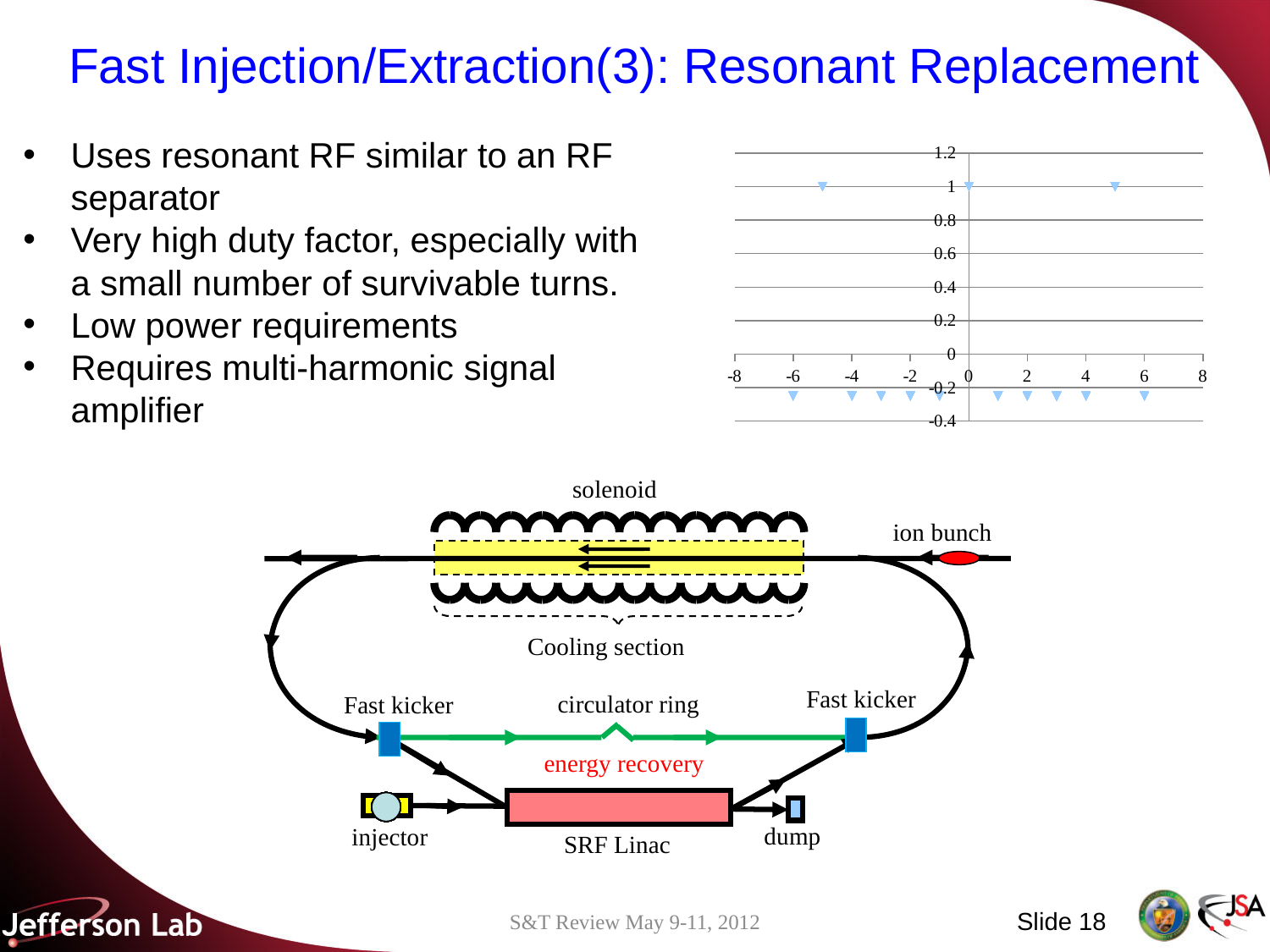
In the scatter chart, is the y value of the point at x = 3 greater or less than 0.2? less What range does the x axis of the scatter chart span? -8 to 8 How many data points are plotted in the scatter chart? 12 In the scatter chart, what is the y value of the point at x = 5? 1 In the scatter chart, is the y value of the point at x = 2 greater or less than 0? less In the scatter chart, what is the highest y value reached by any plotted point? 1 In the scatter chart, is the y value of the point at x = -6 greater or less than 0? less In the scatter chart, which point has the larger y value, the one at x = 0 or the one at x = 1? x = 0 In the scatter chart, what is the y value of the point at x = -5? 1 What is the highest tick value shown on the y axis of the scatter chart? 1.2 In the scatter chart, what is the y value of the point at x = 0? 1 What kind of chart is shown in the upper right of the slide? scatter chart